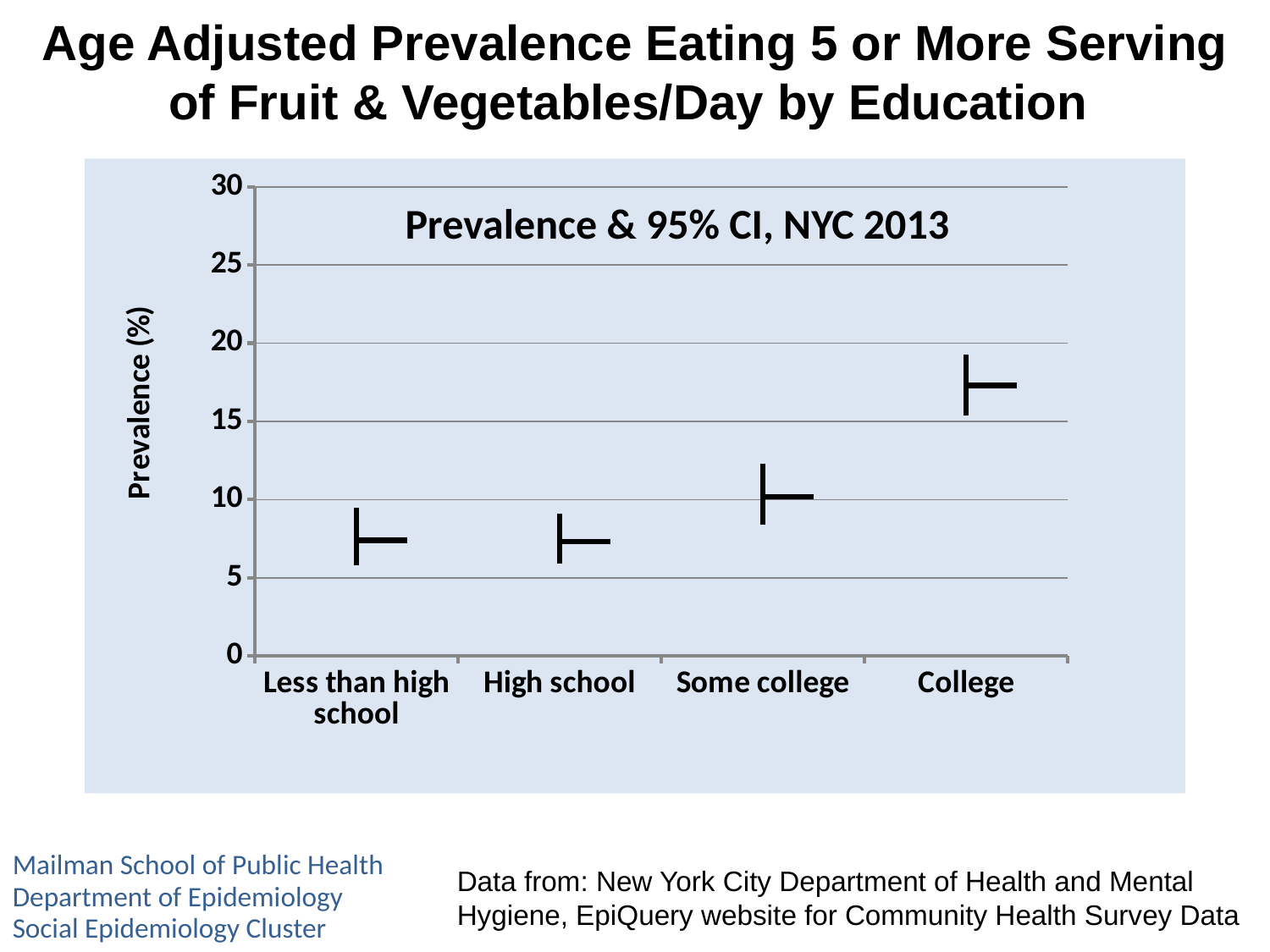
Which has a higher prevalence, Some college or High school? Some college Is the prevalence for Less than high school greater or less than 5? greater Does prevalence generally rise or fall as education level increases along the x axis? rise Is the prevalence for College greater or less than 20? less How many education categories are shown on the x axis? 4 What is the title printed inside the chart area? Prevalence & 95% CI, NYC 2013 Is the prevalence for High school greater or less than 10? less Which has a higher prevalence, College or Some college? College What is the label of the y axis? Prevalence (%) Which education category has the highest prevalence? College